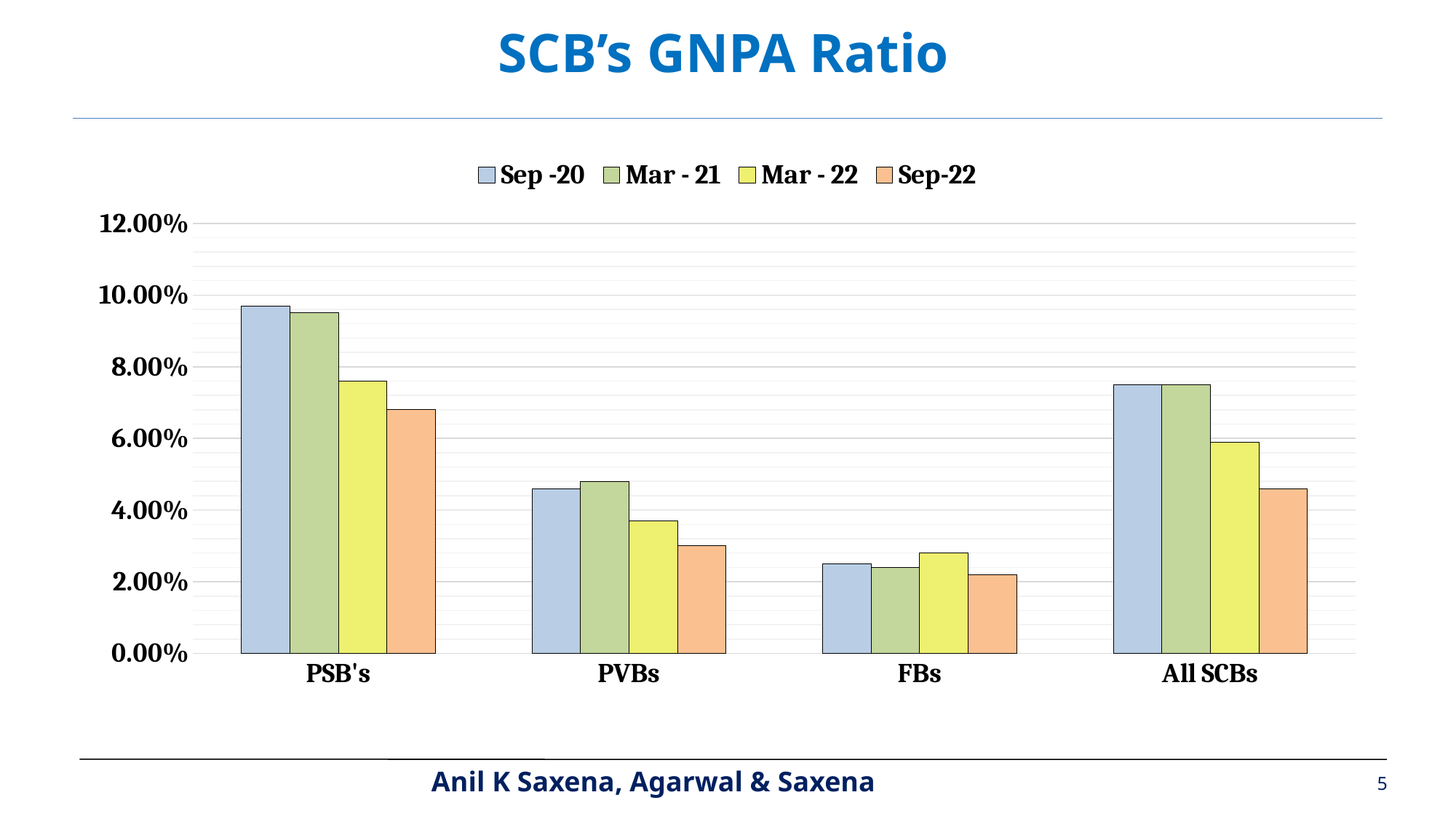
What kind of chart is shown on the slide? bar chart Is the Sep-22 value for PVBs greater or less than 4.00%? less Is the Sep-22 value for All SCBs greater or less than 6.00%? less Which category has the lowest Sep-22 GNPA ratio? FBs How many bank categories are shown on the x axis? 4 What colour are the Sep-22 bars? orange Which category has the highest Sep-22 GNPA ratio? PSB's Which is larger, the Mar - 22 value for PSB's or the Mar - 22 value for All SCBs? PSB's How many series does the legend list? 4 Is the Sep -20 value for PSB's greater or less than 8.00%? greater For PSB's, do the values rise or fall from Sep -20 to Sep-22? fall What is the title of the chart? SCB's GNPA Ratio